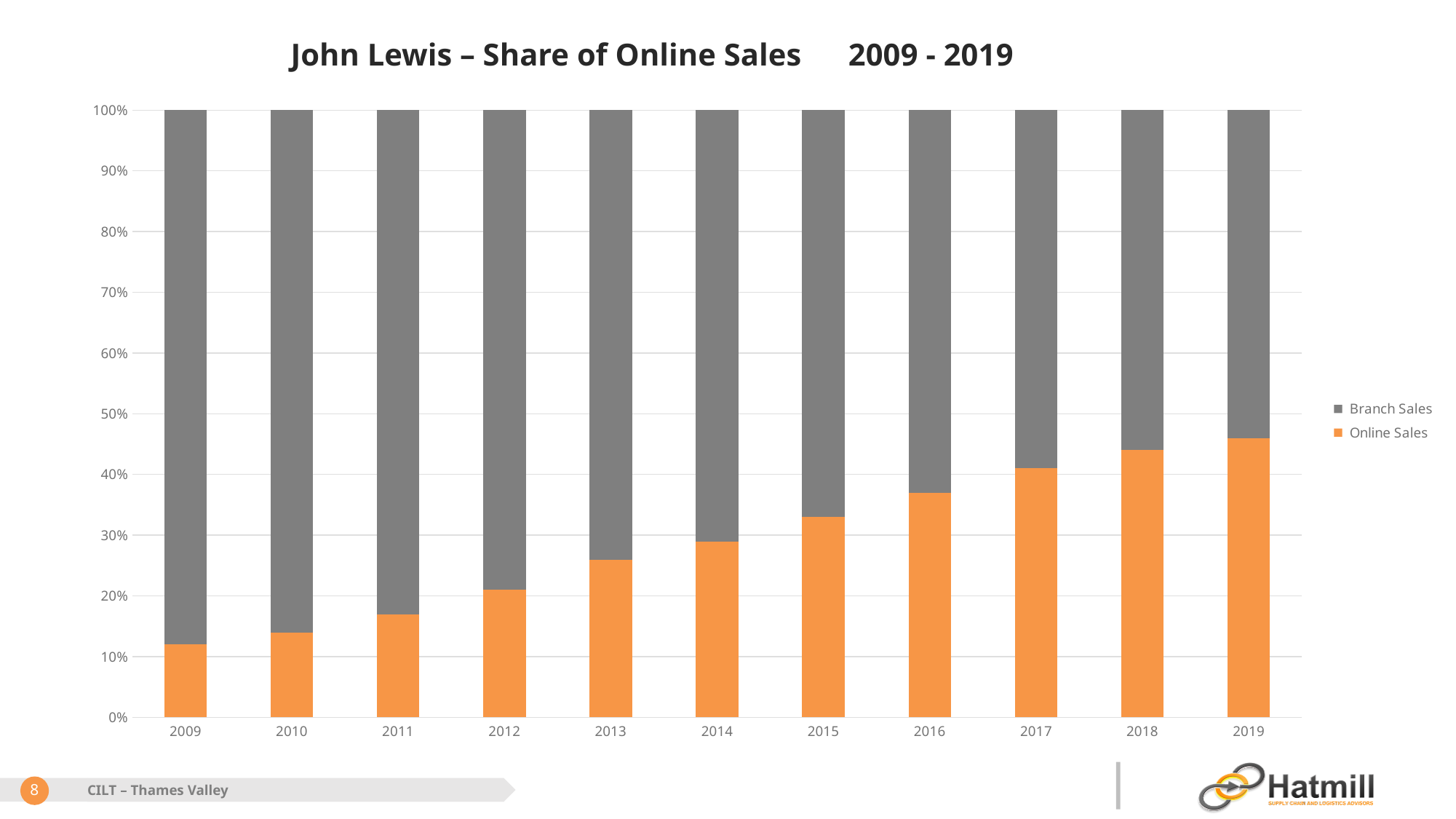
In which year is the Online Sales share lowest? 2009 How many series does the legend list? 2 What kind of chart is shown on the slide? bar chart Is the Online Sales share for 2009 greater or less than 20%? less In which year is the Online Sales share highest? 2019 Which year has the larger Online Sales share, 2011 or 2015? 2015 What is the total of the stacked bar for 2015? 100% How many years are shown along the x axis? 11 Is the Online Sales share for 2019 greater or less than 40%? greater Which colour represents Online Sales in the legend? orange Is the Online Sales share for 2016 greater or less than 30%? greater Does the Online Sales share rise or fall from 2009 to 2019? rise